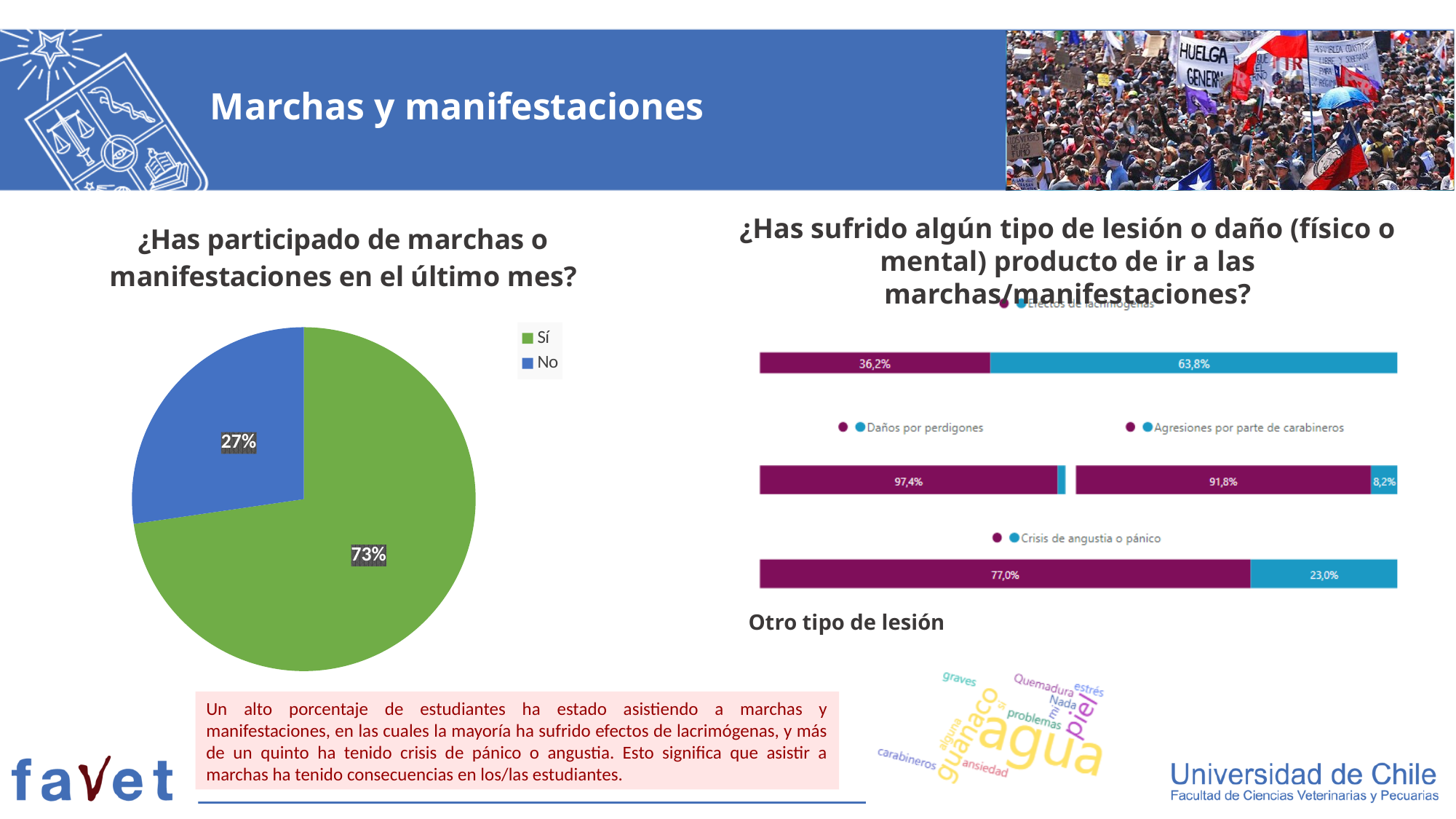
In the pie chart '¿Has participado de marchas o manifestaciones en el último mes?', what percentage answered Sí? 73% In the bar charts on the right, what is the value of the blue segment for 'Crisis de angustia o pánico'? 23,0% What type of chart is used for the question '¿Has participado de marchas o manifestaciones en el último mes?'? Pie chart In the bar charts on the right, what is the value of the purple segment for 'Efectos de lacrimógenas'? 36,2% In the pie chart on the left, which colour represents the Sí slice? Green In the pie chart '¿Has participado de marchas o manifestaciones en el último mes?', what percentage answered No? 27% In the bar charts on the right, what is the value of the blue segment for 'Efectos de lacrimógenas'? 63,8% How many entries does the legend of the pie chart on the left list? 2 In the bar charts on the right, what is the value of the blue segment for 'Agresiones por parte de carabineros'? 8,2% In the pie chart on the left, what is the difference in percentage points between the Sí and No slices? 46% In the pie chart on the left, which response has the larger share, Sí or No? Sí In the bar charts on the right, what is the value of the purple segment for 'Daños por perdigones'? 97,4%